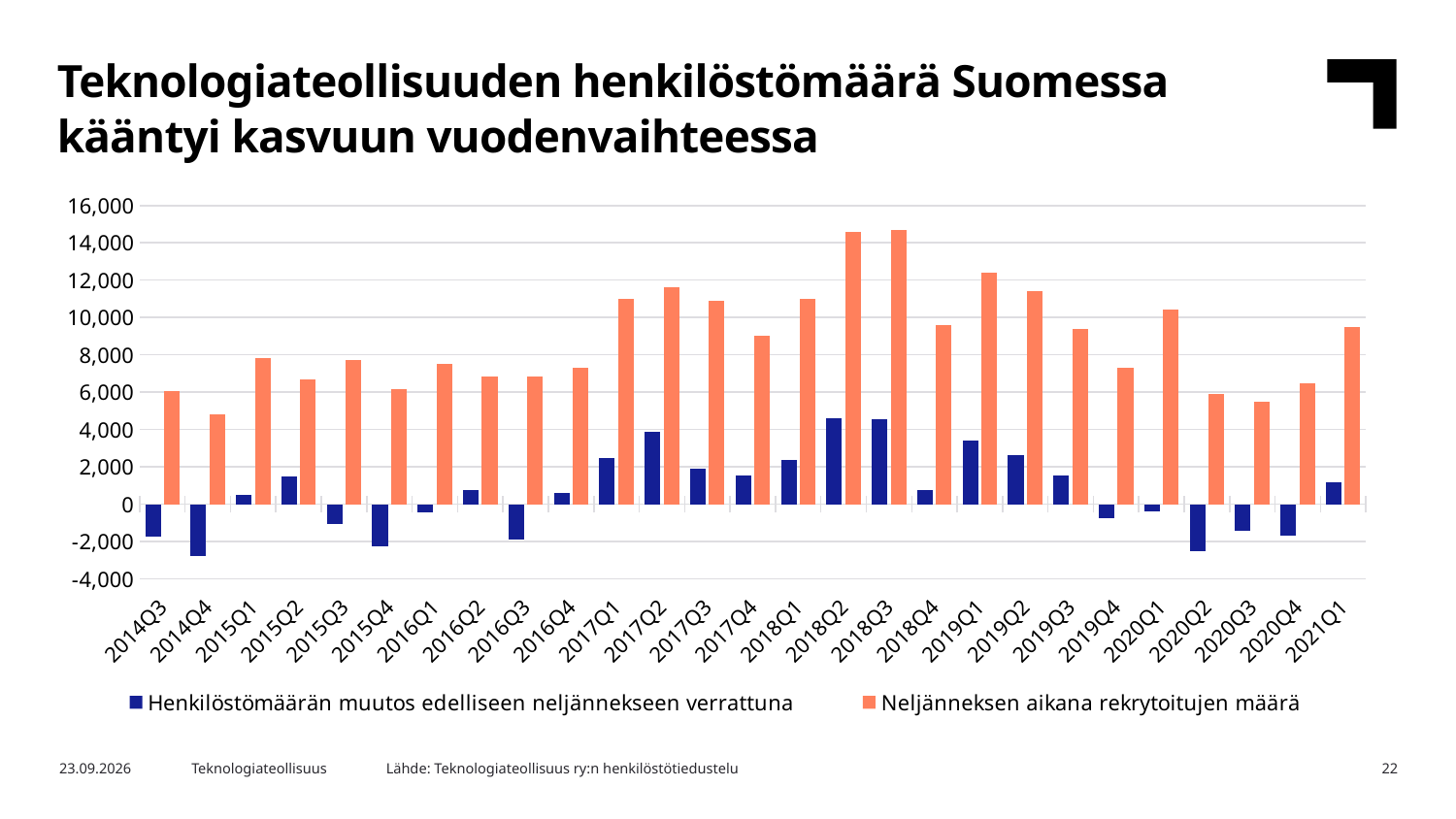
Which colour represents 'Neljänneksen aikana rekrytoitujen määrä' in the chart? Orange Is the value for 'Neljänneksen aikana rekrytoitujen määrä' in 2021Q1 greater or less than 8,000? greater Is the value for 'Neljänneksen aikana rekrytoitujen määrä' in 2018Q3 greater or less than 14,000? greater How many quarters are shown on the x axis? 27 Is the value for 'Neljänneksen aikana rekrytoitujen määrä' in 2014Q4 greater or less than 6,000? less What kind of chart is shown on the slide? Bar chart Which is larger for 'Henkilöstömäärän muutos edelliseen neljännekseen verrattuna': 2019Q1 or 2019Q2? 2019Q1 Which is larger for 'Neljänneksen aikana rekrytoitujen määrä': 2016Q4 or 2017Q1? 2017Q1 How many series does the legend list? 2 Which quarter has the lowest value for 'Neljänneksen aikana rekrytoitujen määrä'? 2014Q4